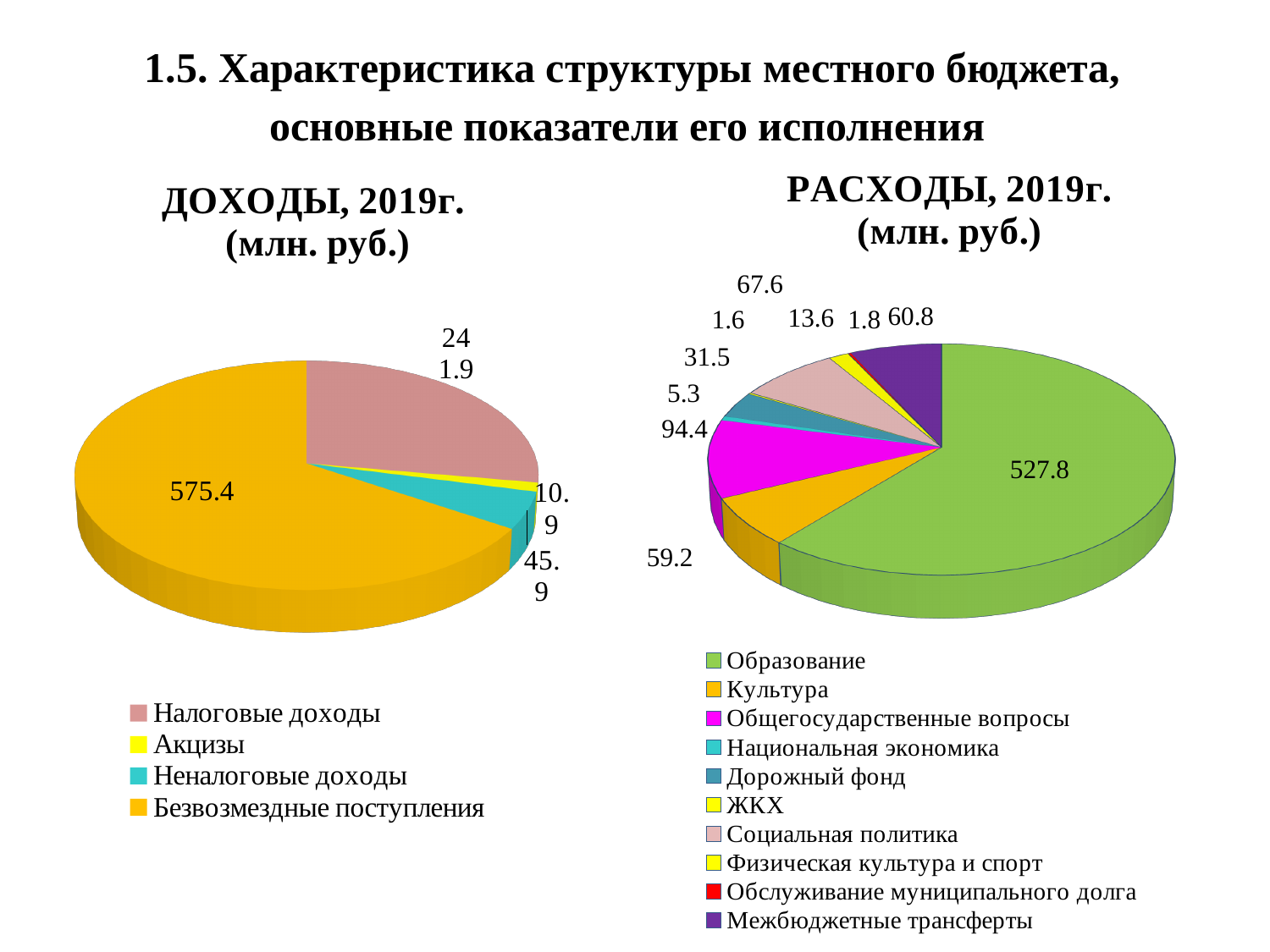
In the "ДОХОДЫ, 2019г." chart, what is the value for Безвозмездные поступления? 575.4 In the "ДОХОДЫ, 2019г." chart, which category has the smallest slice? Акцизы How many categories does the legend of the "ДОХОДЫ, 2019г." chart list? 4 In the "РАСХОДЫ, 2019г." chart, what is the value for Образование? 527.8 In the "РАСХОДЫ, 2019г." chart, what is the difference between the values for Образование and Общегосударственные вопросы? 433.4 How many categories does the legend of the "РАСХОДЫ, 2019г." chart list? 10 In the "РАСХОДЫ, 2019г." chart, what is the value for Межбюджетные трансферты? 60.8 What kind of chart is the "ДОХОДЫ, 2019г." chart? pie chart In the "РАСХОДЫ, 2019г." chart, which category has the largest slice? Образование In the "РАСХОДЫ, 2019г." chart, what is the value for Общегосударственные вопросы? 94.4 In the "РАСХОДЫ, 2019г." chart, what is the value for Культура? 59.2 In the "ДОХОДЫ, 2019г." chart, which category has the largest slice? Безвозмездные поступления